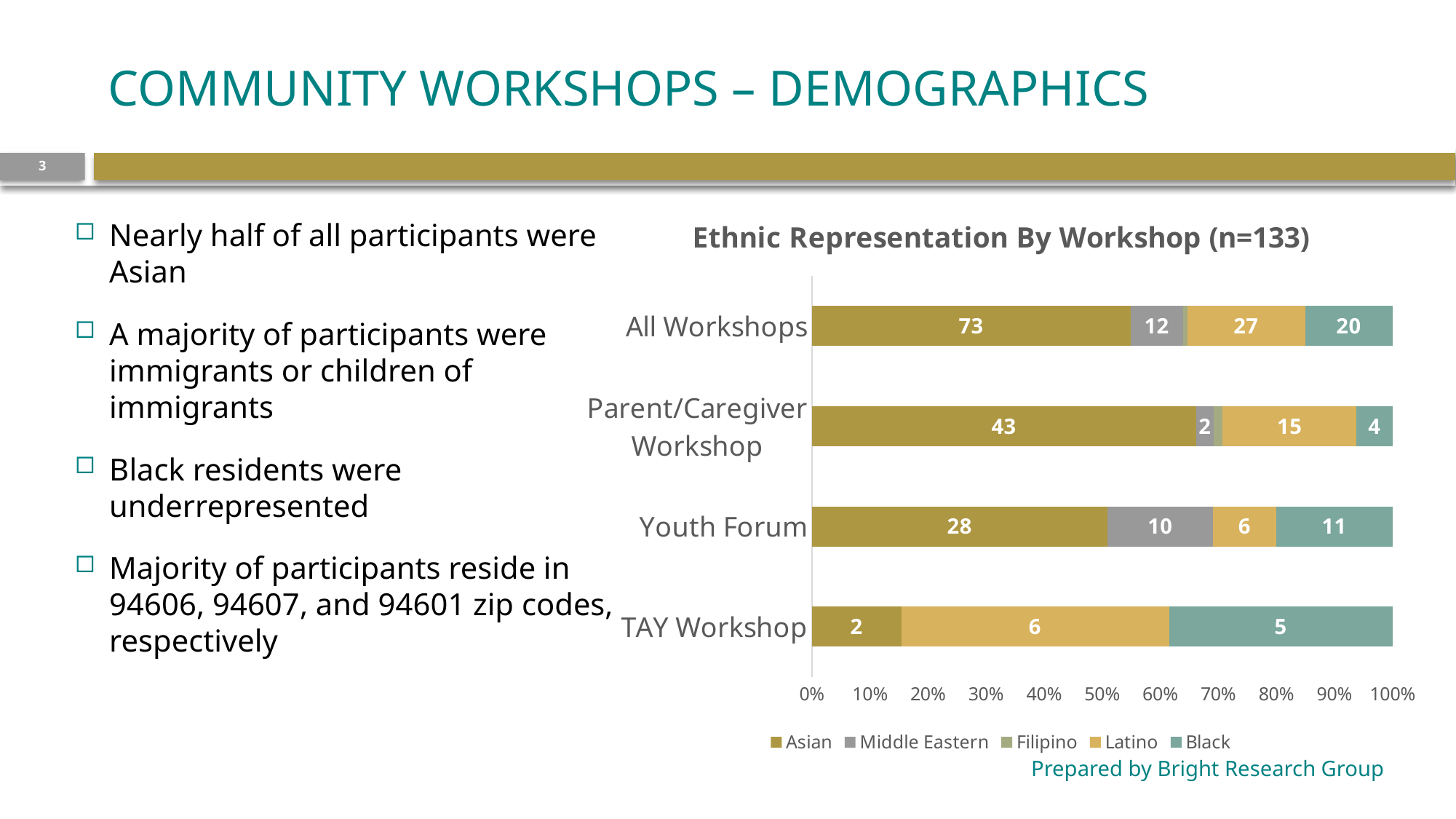
What is the value for Black in the Youth Forum bar? 11 What is the difference between the Asian value and the Latino value in the All Workshops bar? 46 Which is larger in the Youth Forum bar: the Middle Eastern value or the Latino value? Middle Eastern What is the value for Middle Eastern in the Youth Forum bar? 10 How many workshop categories are shown on the y axis? 4 Which ethnic group has the largest labelled value in the Parent/Caregiver Workshop bar? Asian What kind of chart is shown on the slide? Stacked bar chart What is the value for Latino in the TAY Workshop bar? 6 How many series does the legend list? 5 Which ethnic group has the smallest labelled value in the TAY Workshop bar? Asian What is the value for Asian in the All Workshops bar? 73 What is the value for Latino in the Parent/Caregiver Workshop bar? 15